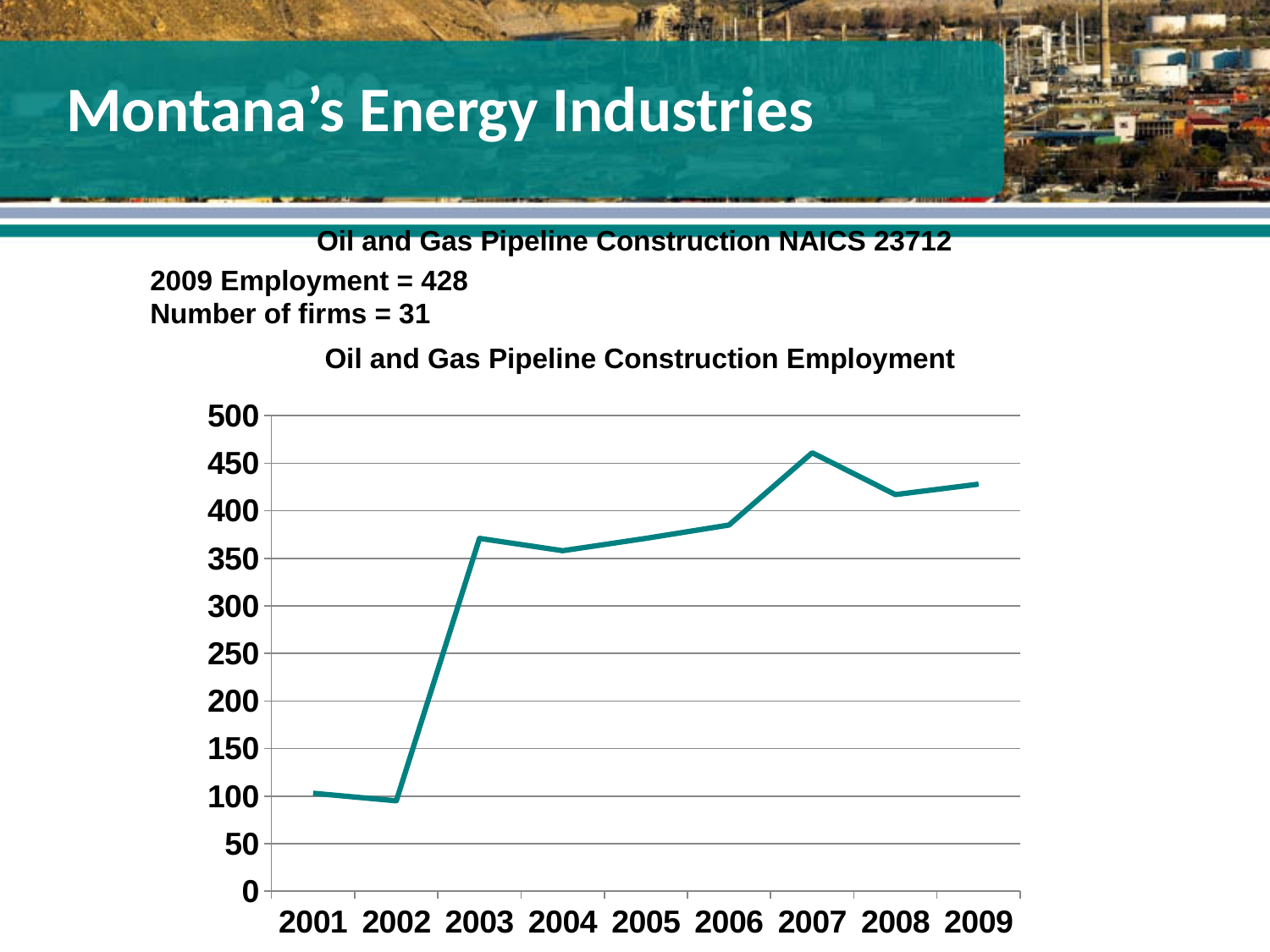
Is the employment value for 2003 greater or less than 350? greater What kind of chart is shown on the slide? line chart What is the employment value for 2009 in the Oil and Gas Pipeline Construction Employment chart? 428 Does employment rise or fall between 2007 and 2008? fall Which year has higher employment, 2007 or 2008? 2007 Does employment rise or fall between 2002 and 2003? rise How many years are plotted on the x axis of the Oil and Gas Pipeline Construction Employment chart? 9 Is the employment value for 2006 greater or less than 400? less Which year has the highest employment in the Oil and Gas Pipeline Construction Employment chart? 2007 Is the employment value for 2007 greater or less than 450? greater What is the title of the chart on the slide? Oil and Gas Pipeline Construction Employment